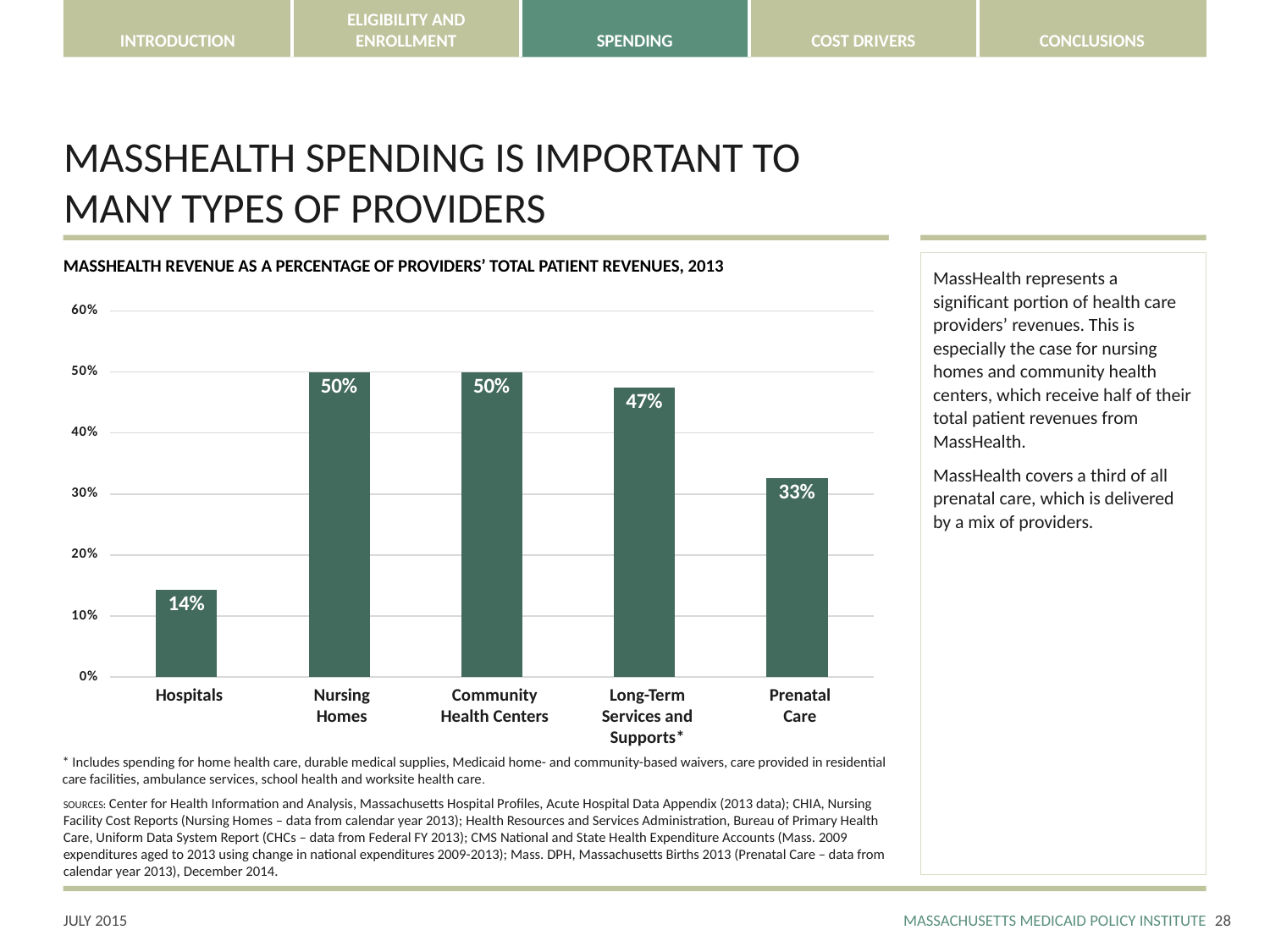
What is the title of the chart? MassHealth Revenue as a Percentage of Providers' Total Patient Revenues, 2013 Is the value for Long-Term Services and Supports greater or less than 40%? greater What is the MassHealth revenue percentage for Long-Term Services and Supports? 47% Which provider type has the lowest MassHealth revenue percentage? Hospitals What is the difference between the values for Nursing Homes and Hospitals? 36% What is the MassHealth revenue percentage for Hospitals? 14% What is the difference between the values for Long-Term Services and Supports and Prenatal Care? 14% What is the MassHealth revenue percentage for Prenatal Care? 33% What kind of chart is shown on the slide? Bar chart Which two provider types share the same value of 50%? Nursing Homes and Community Health Centers Which is larger, the value for Prenatal Care or the value for Hospitals? Prenatal Care How many provider categories are shown in the chart? 5